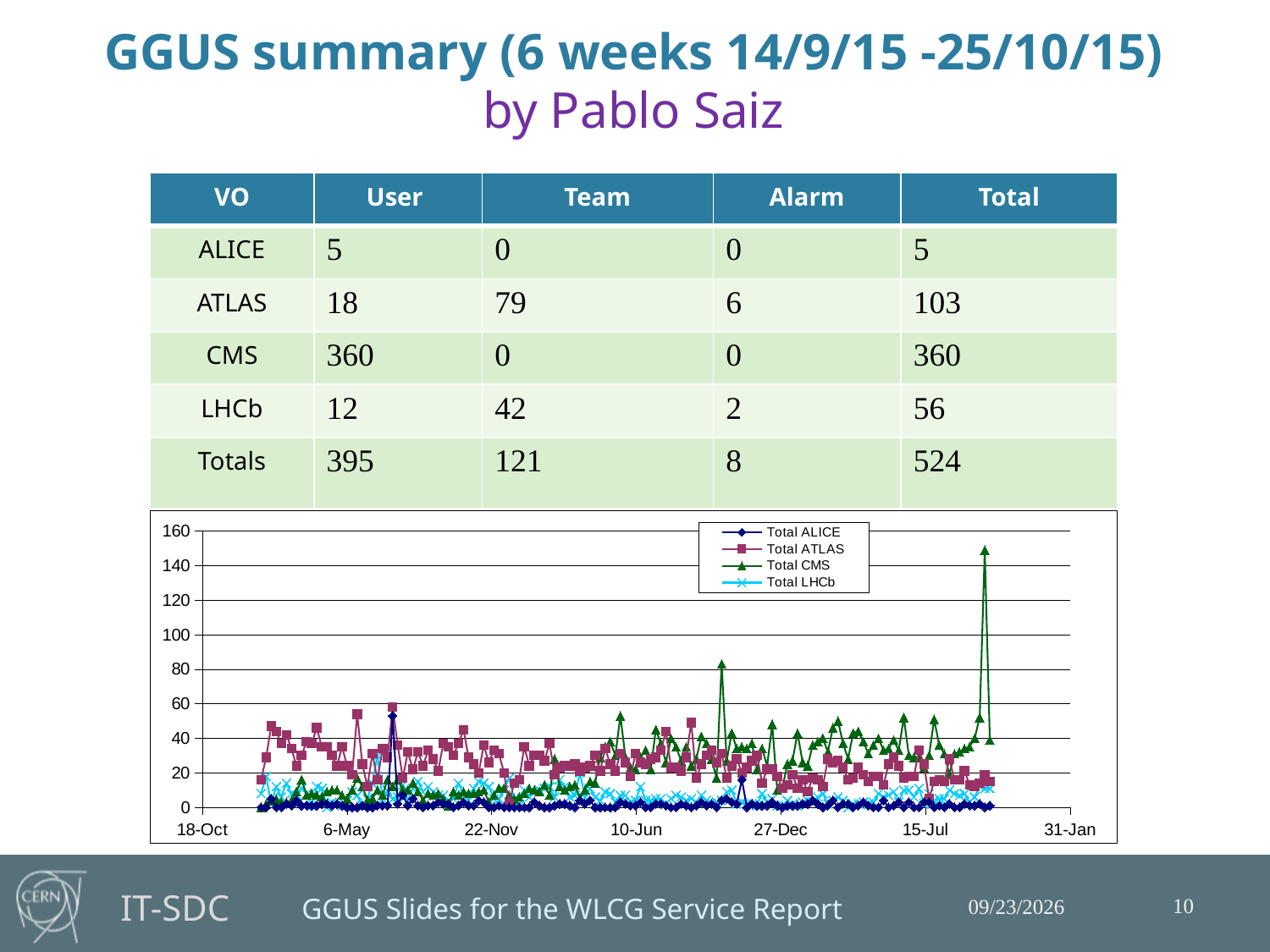
How many date labels are shown on the x axis of the chart? 7 How many series does the chart legend list? 4 Which series has the higher peak value, Total CMS or Total ATLAS? Total CMS What is the first date label on the x axis of the chart? 18-Oct Is the highest peak of the Total ALICE series greater or less than 40? greater Is the highest peak of the Total LHCb series greater or less than 60? less Is the highest peak of the Total CMS series greater or less than 140? greater What is the name of the series drawn in green on the chart? Total CMS Which series reaches the highest value on the chart? Total CMS What kind of chart is shown on the slide? line chart